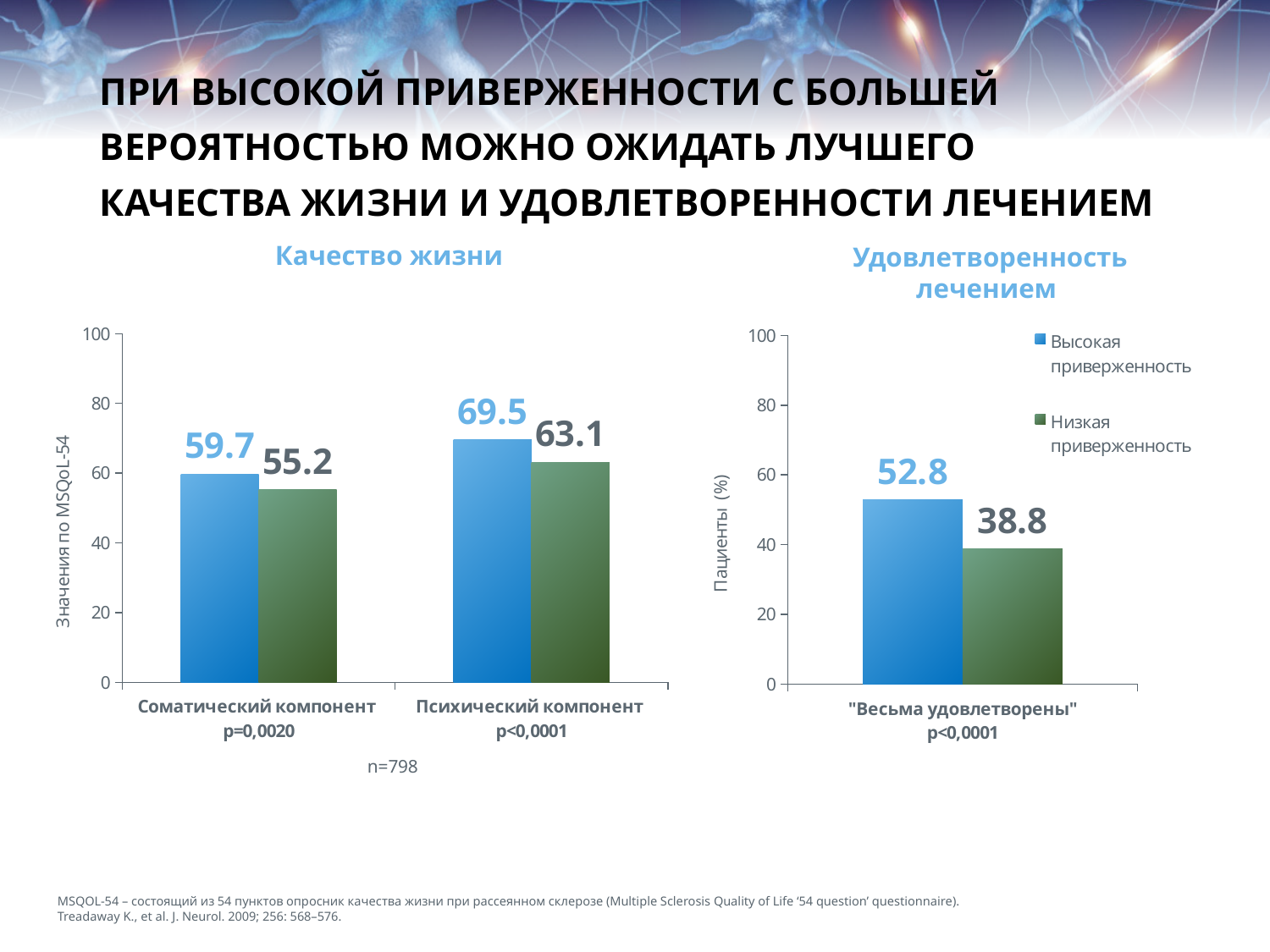
What type of chart is the "Удовлетворенность лечением" chart? Bar chart How many categories are shown on the x axis of the "Качество жизни" chart? 2 In the "Удовлетворенность лечением" chart, what is the value for "Высокая приверженность"? 52.8 In the "Удовлетворенность лечением" chart, what is the difference between the "Высокая приверженность" and "Низкая приверженность" values? 14.0 In the "Качество жизни" chart, which is larger in the "Соматический компонент" category: "Высокая приверженность" or "Низкая приверженность"? Высокая приверженность In the "Качество жизни" chart, what is the value for "Низкая приверженность" in the "Психический компонент" category? 63.1 In the "Удовлетворенность лечением" chart, what is the value for "Низкая приверженность"? 38.8 In the "Качество жизни" chart, which bar has the highest value? Высокая приверженность, Психический компонент (69.5) In the "Качество жизни" chart, what is the difference between the "Высокая приверженность" and "Низкая приверженность" values in the "Психический компонент" category? 6.4 How many series does the legend of the "Удовлетворенность лечением" chart list? 2 In the "Качество жизни" chart, which bar has the lowest value? Низкая приверженность, Соматический компонент (55.2) In the "Качество жизни" chart, what is the value for "Высокая приверженность" in the "Соматический компонент" category? 59.7